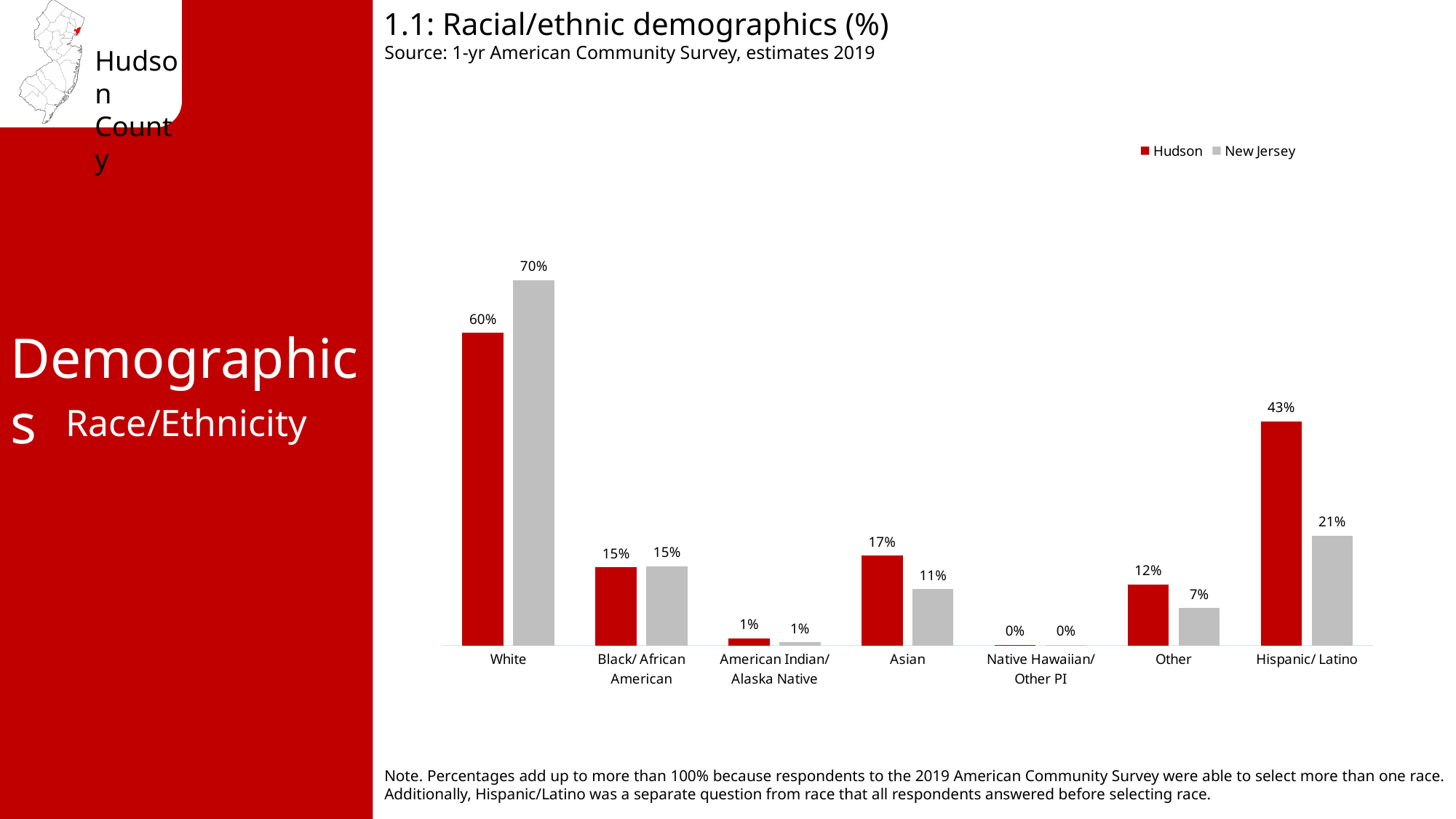
Which category has the lowest Hudson value? Native Hawaiian/ Other PI What is the difference between the New Jersey and Hudson values for White? 10% What is the Hudson value for Asian? 17% What is the New Jersey value for Other? 7% Which category has the highest New Jersey value? White What is the difference between the Hudson and New Jersey values for Hispanic/ Latino? 22% What is the Hudson value for White? 60% How many series does the legend list? 2 What kind of chart is shown on the slide? Bar chart How many categories are shown on the x axis? 7 Which is larger for Asian, the Hudson value or the New Jersey value? Hudson What is the New Jersey value for Hispanic/ Latino? 21%